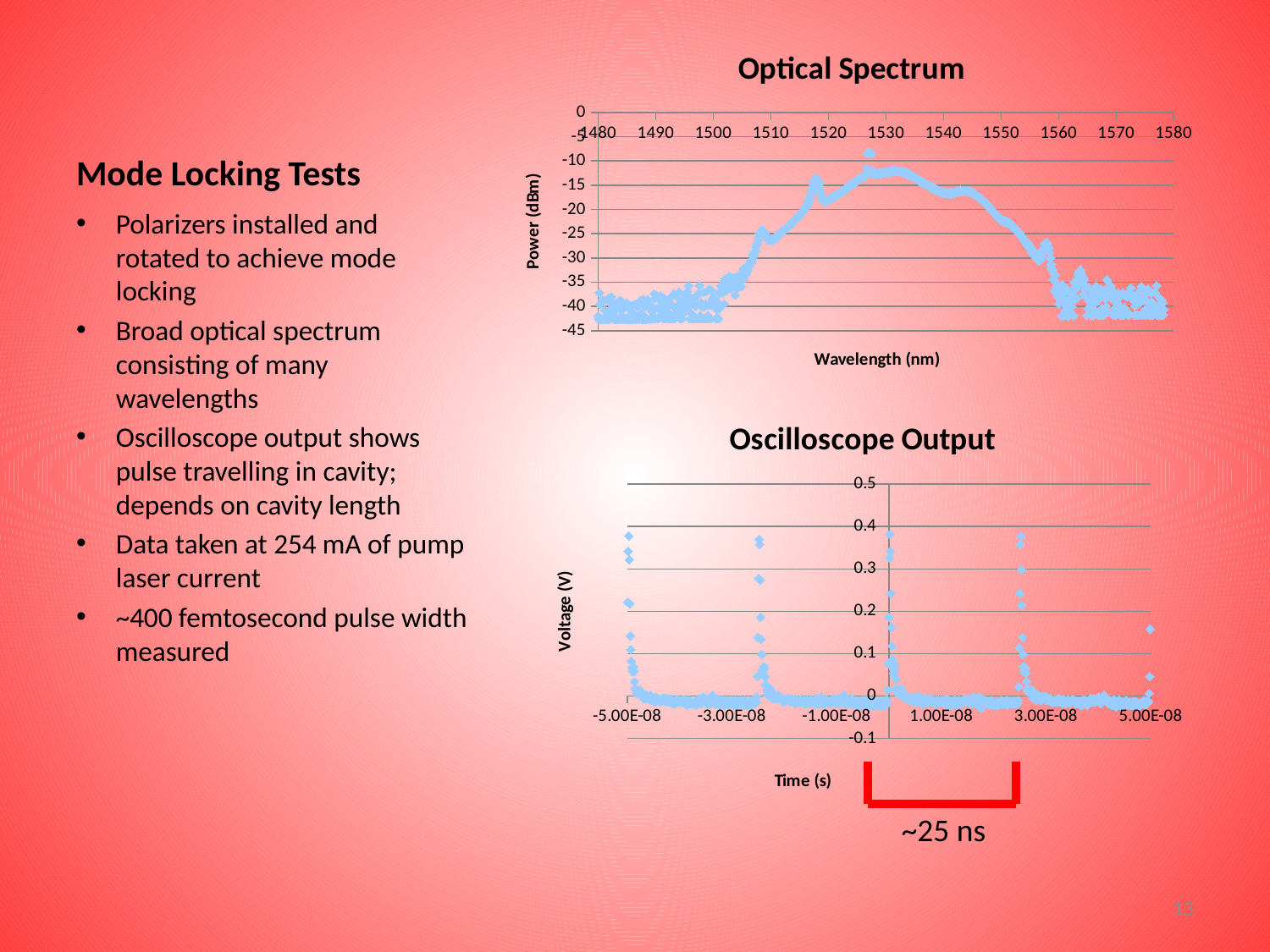
In the Oscilloscope Output chart, is the peak voltage near time 0 greater or less than 0.3 V? greater What kind of chart is the Optical Spectrum chart? scatter chart In the Optical Spectrum chart, is the power at 1530 nm greater or less than -20 dBm? greater What kind of chart is the Oscilloscope Output chart? scatter chart In the Optical Spectrum chart, does the power rise or fall as wavelength increases from 1540 nm to 1560 nm? fall In the Optical Spectrum chart, is the power at 1490 nm greater or less than -30 dBm? less In the Optical Spectrum chart, does the power rise or fall as wavelength increases from 1500 nm to 1530 nm? rise In the Optical Spectrum chart, is the power higher at 1530 nm or at 1480 nm? 1530 nm In the Optical Spectrum chart, what is the label of the y axis? Power (dBm) In the Oscilloscope Output chart, what is the label of the x axis? Time (s)